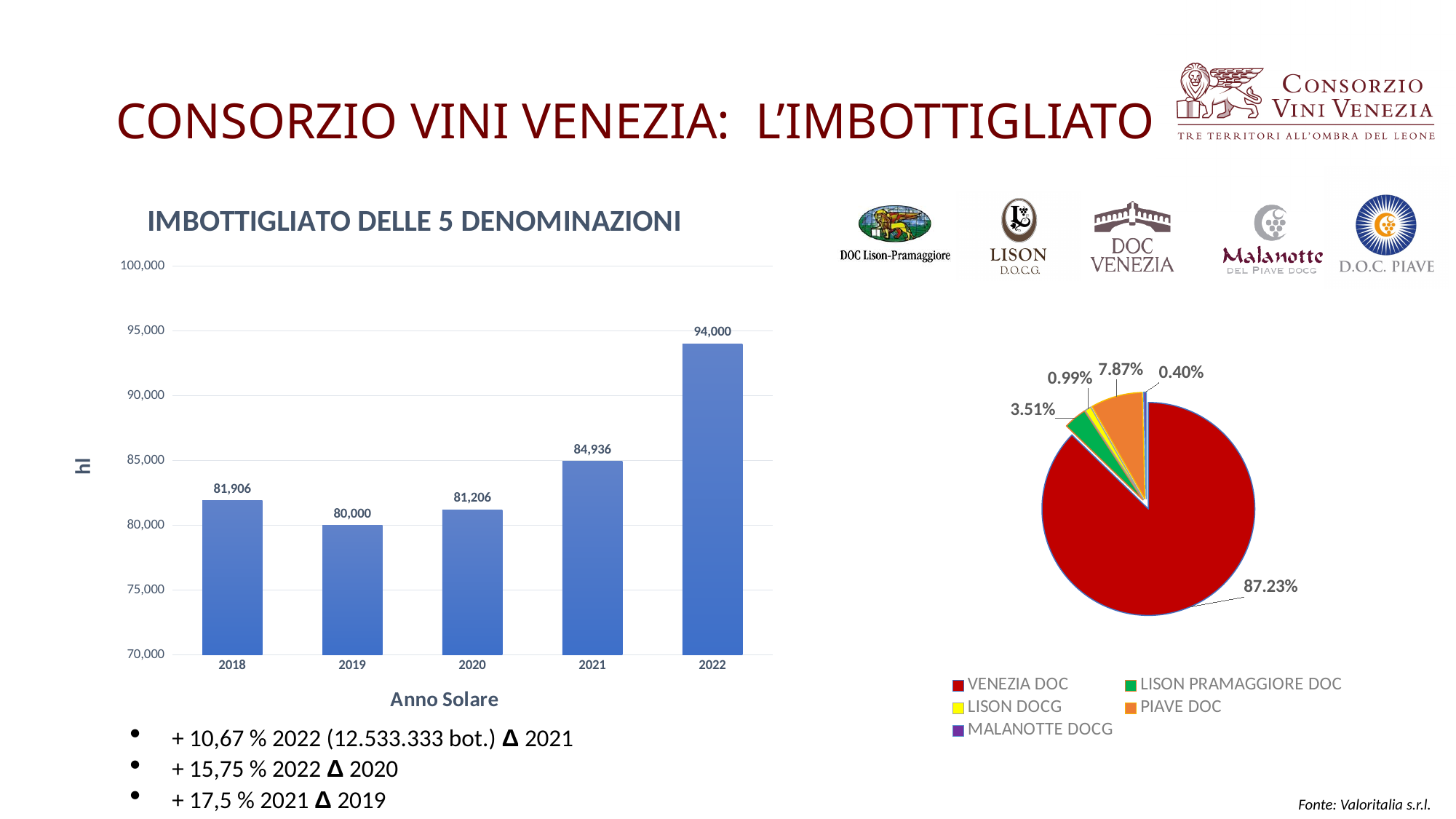
How many entries does the legend of the pie chart on the right list? 5 In the bar chart 'IMBOTTIGLIATO DELLE 5 DENOMINAZIONI', what is the label of the x axis? Anno Solare What kind of chart is 'IMBOTTIGLIATO DELLE 5 DENOMINAZIONI'? bar chart In the pie chart on the right, what share does PIAVE DOC have? 7.87% In the bar chart 'IMBOTTIGLIATO DELLE 5 DENOMINAZIONI', what is the value for 2022? 94,000 In the pie chart on the right, what share does VENEZIA DOC have? 87.23% In the bar chart 'IMBOTTIGLIATO DELLE 5 DENOMINAZIONI', what is the value for 2019? 80,000 In the bar chart 'IMBOTTIGLIATO DELLE 5 DENOMINAZIONI', which is larger, the value for 2018 or the value for 2020? 2018 In the bar chart 'IMBOTTIGLIATO DELLE 5 DENOMINAZIONI', which year has the highest value? 2022 In the bar chart 'IMBOTTIGLIATO DELLE 5 DENOMINAZIONI', what is the difference between the 2022 and 2021 values? 9,064 How many years are shown in the bar chart 'IMBOTTIGLIATO DELLE 5 DENOMINAZIONI'? 5 In the bar chart 'IMBOTTIGLIATO DELLE 5 DENOMINAZIONI', which year has the lowest value? 2019